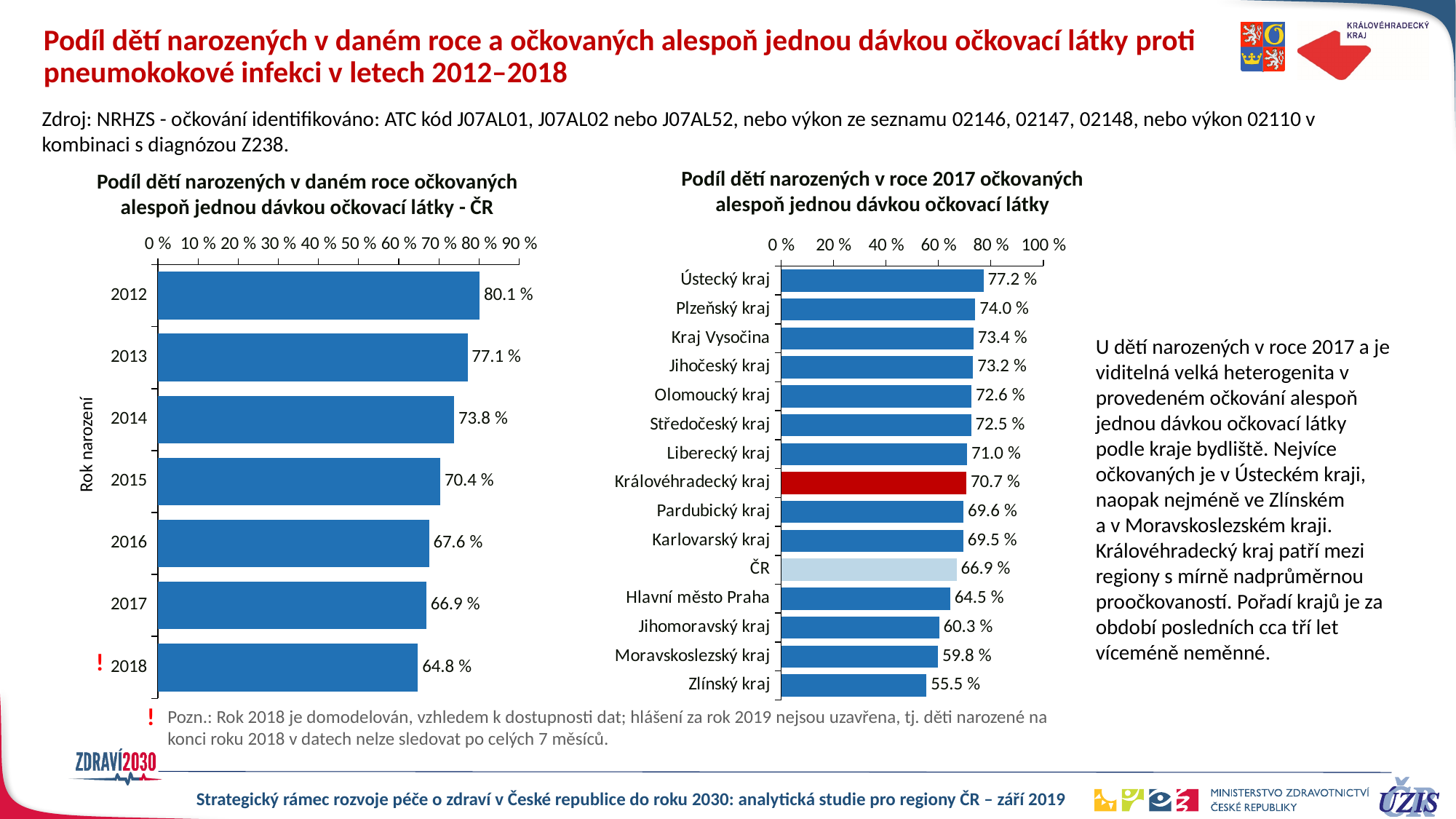
In the right chart (regions, 2017), which region has the highest value? Ústecký kraj In the left chart (ČR by year of birth), what is the difference between the values for 2012 and 2018? 15.3 % In the left chart (ČR by year of birth), how many years are plotted? 7 In the right chart (regions, 2017), which region has the lowest value? Zlínský kraj In the left chart (ČR by year of birth), do the values rise or fall from 2012 to 2018? fall In the right chart (regions, 2017), what is the difference between Ústecký kraj and Zlínský kraj? 21.7 % In the right chart (Podíl dětí narozených v roce 2017 očkovaných alespoň jednou dávkou očkovací látky), what is the value for Královéhradecký kraj? 70.7 % In the left chart (ČR by year of birth), which year has the lowest value? 2018 In the left chart (Podíl dětí narozených v daném roce očkovaných alespoň jednou dávkou očkovací látky - ČR), what is the value for 2014? 73.8 % In the left chart (ČR by year of birth), which year has the highest value? 2012 In the right chart (regions, 2017), which is larger, the value for Plzeňský kraj or the value for Jihomoravský kraj? Plzeňský kraj What type of chart is the right chart (regions, 2017)? bar chart